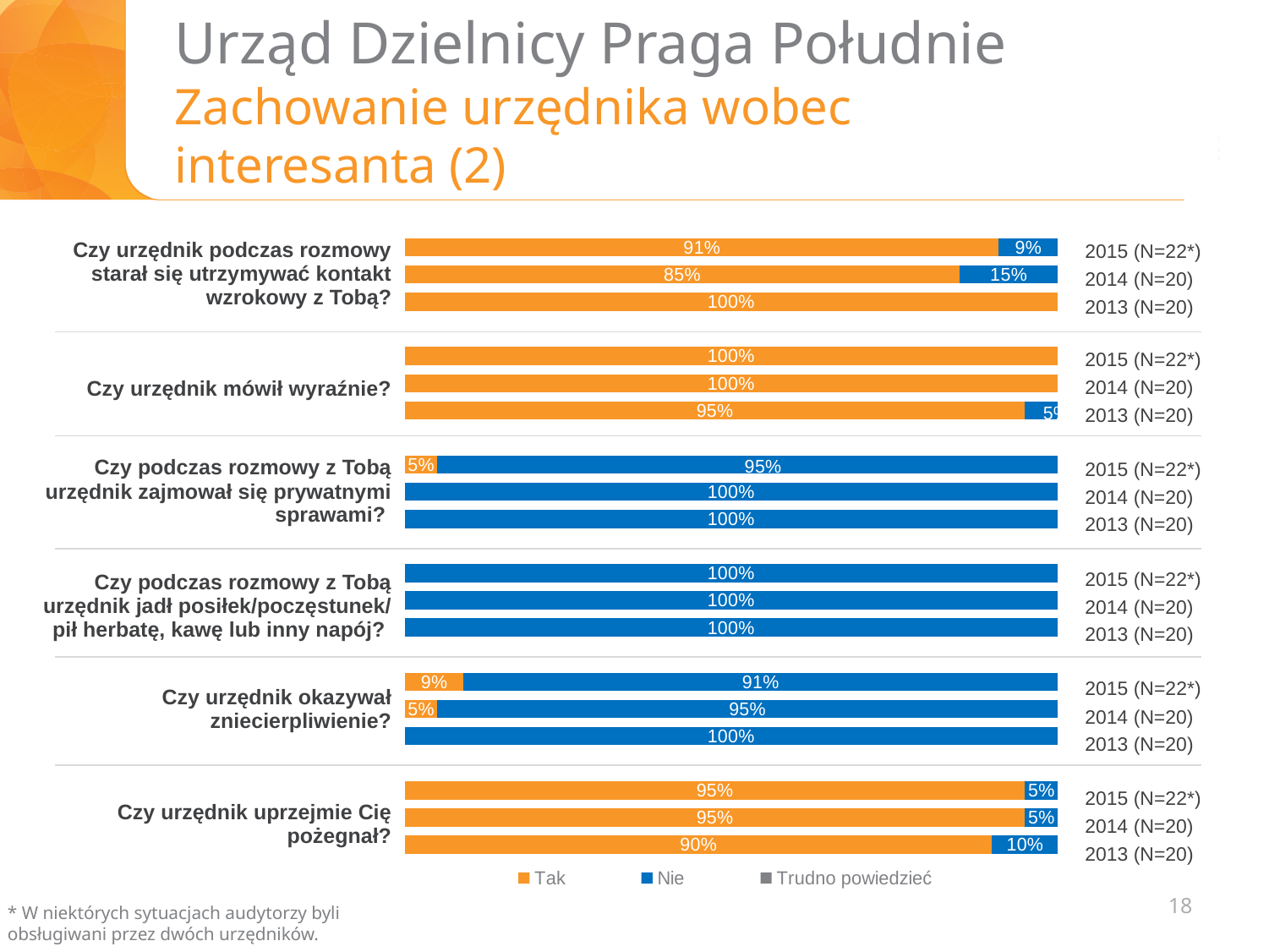
What percentage answered "Tak" in 2015 (N=22*) to "Czy urzędnik okazywał zniecierpliwienie?"? 9% What are the three legend entries of the chart? Tak, Nie, Trudno powiedzieć What percentage answered "Nie" in 2013 (N=20) to "Czy urzędnik uprzejmie Cię pożegnał?"? 10% What percentage answered "Nie" in 2015 (N=22*) to "Czy podczas rozmowy z Tobą urzędnik zajmował się prywatnymi sprawami?"? 95% What percentage answered "Tak" in 2013 (N=20) to "Czy urzędnik mówił wyraźnie?"? 95% What kind of chart is shown on the slide? Stacked bar chart How many survey questions are shown on the chart? 6 For "Czy urzędnik uprzejmie Cię pożegnał?", which year had the larger "Tak" share: 2013 or 2015? 2015 How many series does the legend list? 3 What percentage answered "Nie" in 2014 (N=20) to "Czy urzędnik podczas rozmowy starał się utrzymywać kontakt wzrokowy z Tobą?"? 15% By how many percentage points did the "Tak" share for "Czy urzędnik podczas rozmowy starał się utrzymywać kontakt wzrokowy z Tobą?" differ between 2015 (91%) and 2014 (85%)? 6 percentage points What percentage answered "Tak" in 2015 (N=22*) to "Czy urzędnik podczas rozmowy starał się utrzymywać kontakt wzrokowy z Tobą?"? 91%